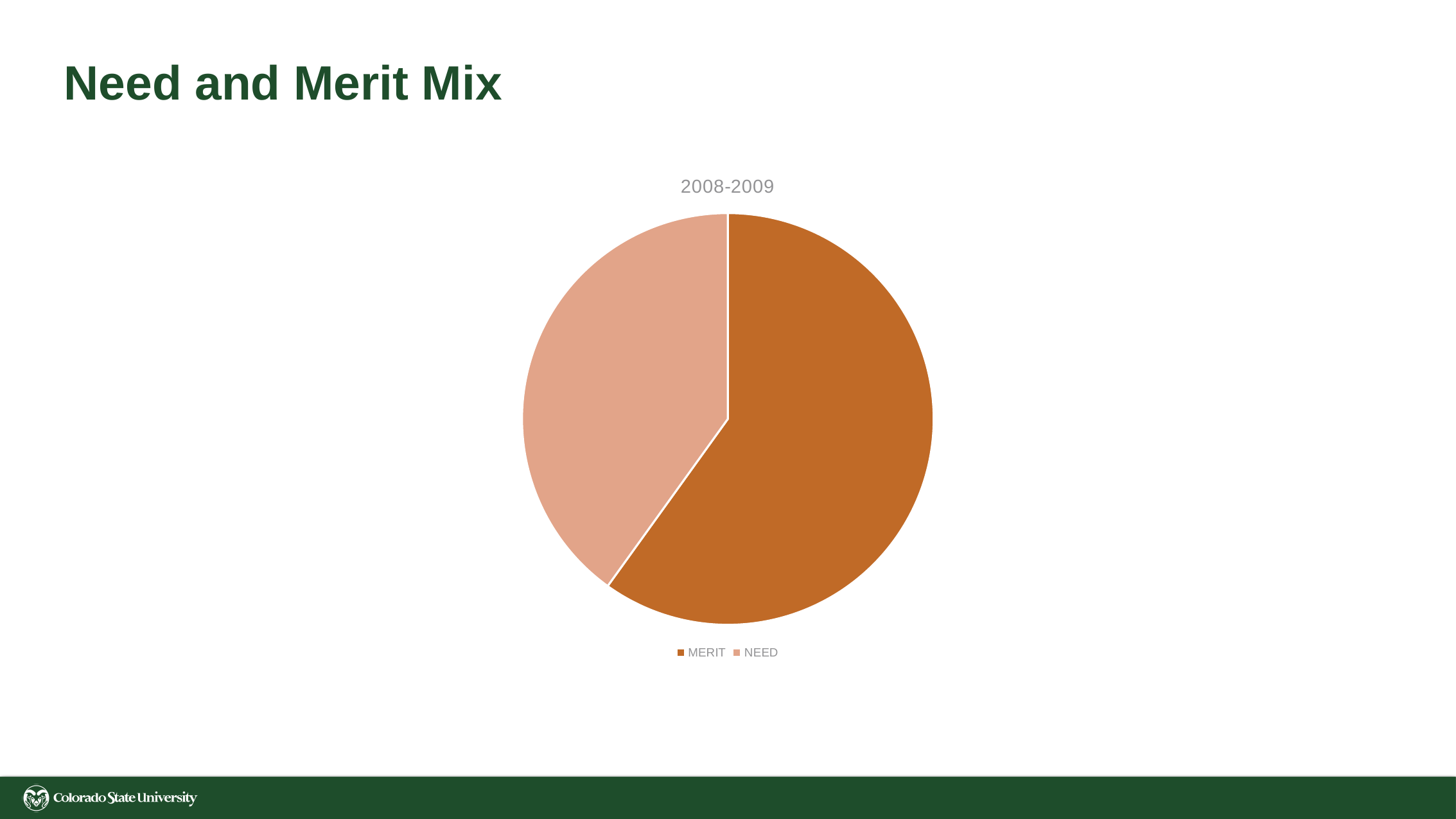
What is the title of the pie chart? 2008-2009 Which category has the smallest slice in the pie chart? NEED How many slices does the pie chart have? 2 Which categories are listed in the legend of the pie chart? MERIT and NEED Which category has the largest slice in the pie chart? MERIT How many entries does the legend of the pie chart list? 2 What kind of chart is shown on the slide? pie chart Does the MERIT slice take up more or less than half of the pie chart? more Which slice is larger in the pie chart, MERIT or NEED? MERIT Does the NEED slice take up more or less than half of the pie chart? less